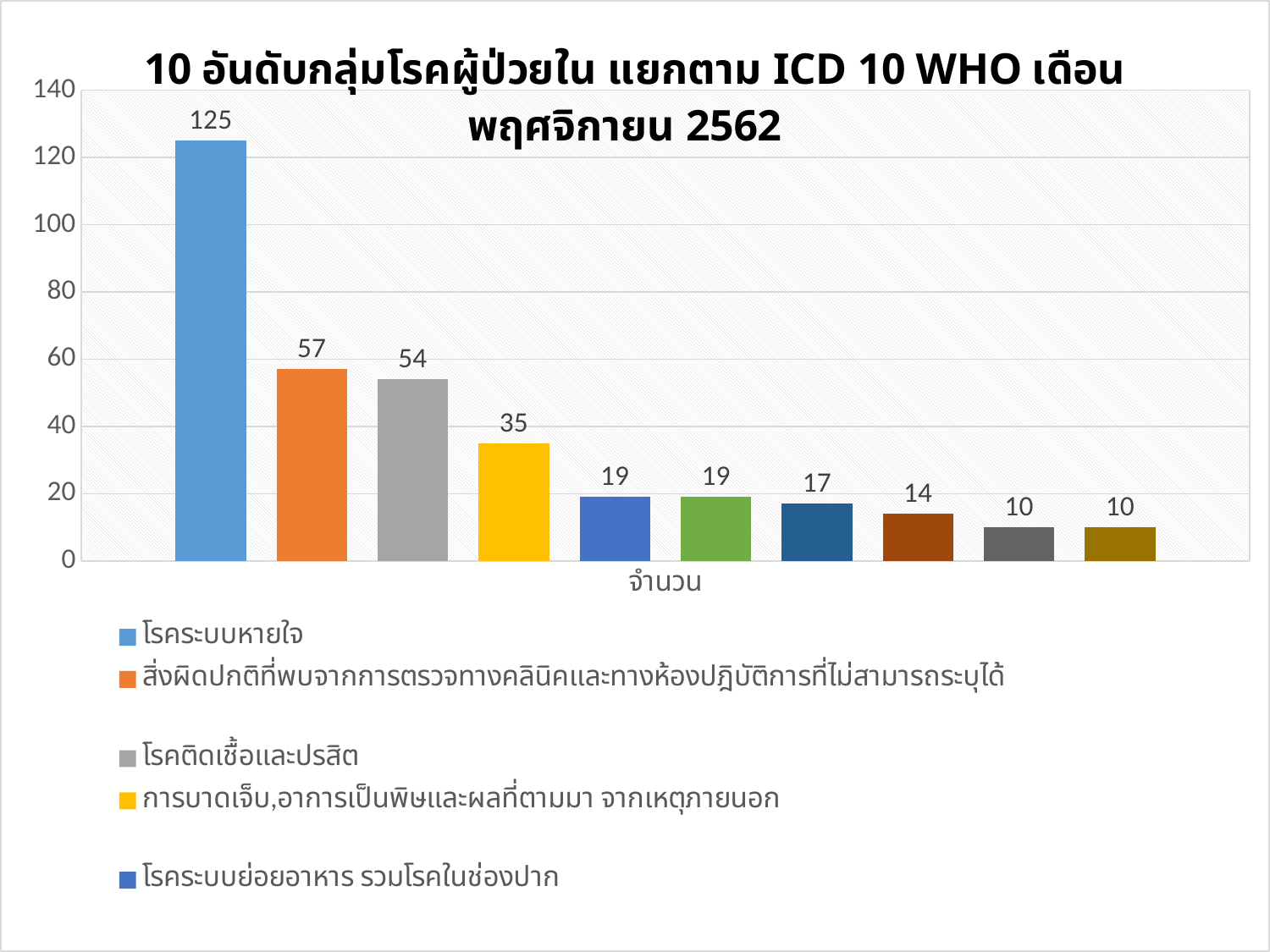
What is the value for โรคระบบหายใจ? 125 What is the difference between the values for โรคระบบหายใจ and สิ่งผิดปกติที่พบจากการตรวจทางคลินิคและทางห้องปฏิบัติการที่ไม่สามารถระบุได้? 68 What is the label shown on the horizontal axis of the chart? จำนวน What type of chart is shown on the slide? bar chart What is the value for การบาดเจ็บ,อาการเป็นพิษและผลที่ตามมา จากเหตุภายนอก? 35 How many bars are plotted in the chart? 10 What is the value shown on the lowest bars in the chart? 10 Which is larger, the value for สิ่งผิดปกติที่พบจากการตรวจทางคลินิคและทางห้องปฏิบัติการที่ไม่สามารถระบุได้ or the value for โรคติดเชื้อและปรสิต? สิ่งผิดปกติที่พบจากการตรวจทางคลินิคและทางห้องปฏิบัติการที่ไม่สามารถระบุได้ What is the value for โรคระบบย่อยอาหาร รวมโรคในช่องปาก? 19 What is the value for โรคติดเชื้อและปรสิต? 54 Which category has the highest value? โรคระบบหายใจ Is the value for โรคระบบหายใจ greater or less than 100? greater